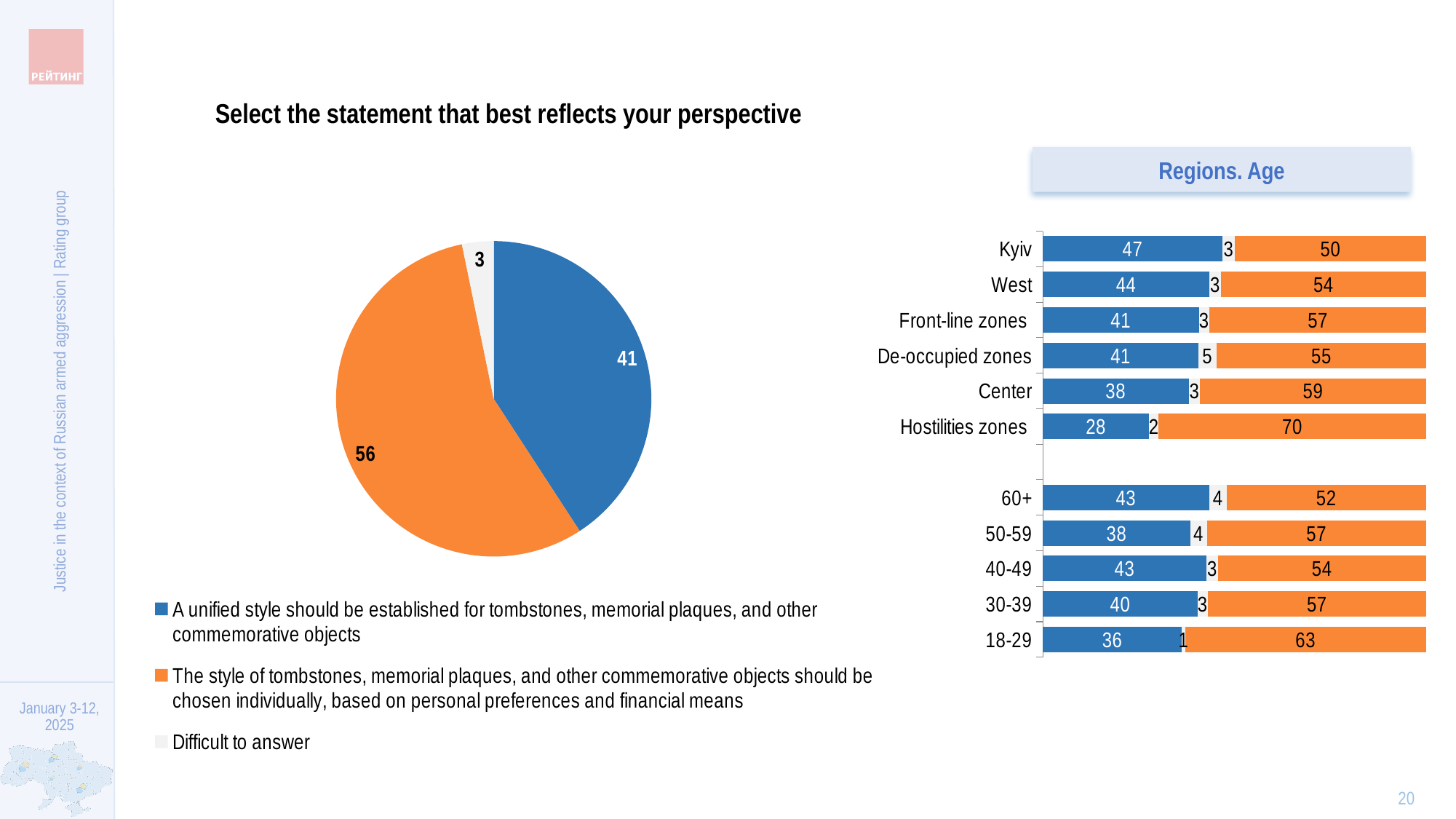
In the 'Regions. Age' bar chart, what is the total of the three segments for De-occupied zones? 101 How many entries does the legend on the slide list? 3 In the pie chart, what is the difference between the 'chosen individually' slice and the 'unified style' slice? 15 In the 'Regions. Age' bar chart, what is the value of the orange segment for Hostilities zones? 70 How many categories are shown in the 'Regions. Age' bar chart? 11 In the 'Regions. Age' bar chart, which region has the lowest blue value? Hostilities zones What type of chart is shown on the left of the slide? pie chart In the pie chart, which option has the largest slice? The style of tombstones, memorial plaques, and other commemorative objects should be chosen individually, based on personal preferences and financial means In the 'Regions. Age' bar chart, which age group has the highest orange value? 18-29 In the 'Regions. Age' bar chart, is the blue value for West larger or the blue value for Center? West In the pie chart, what share of respondents chose 'Difficult to answer'? 3 In the 'Regions. Age' bar chart, what is the value of the blue segment for Kyiv? 47